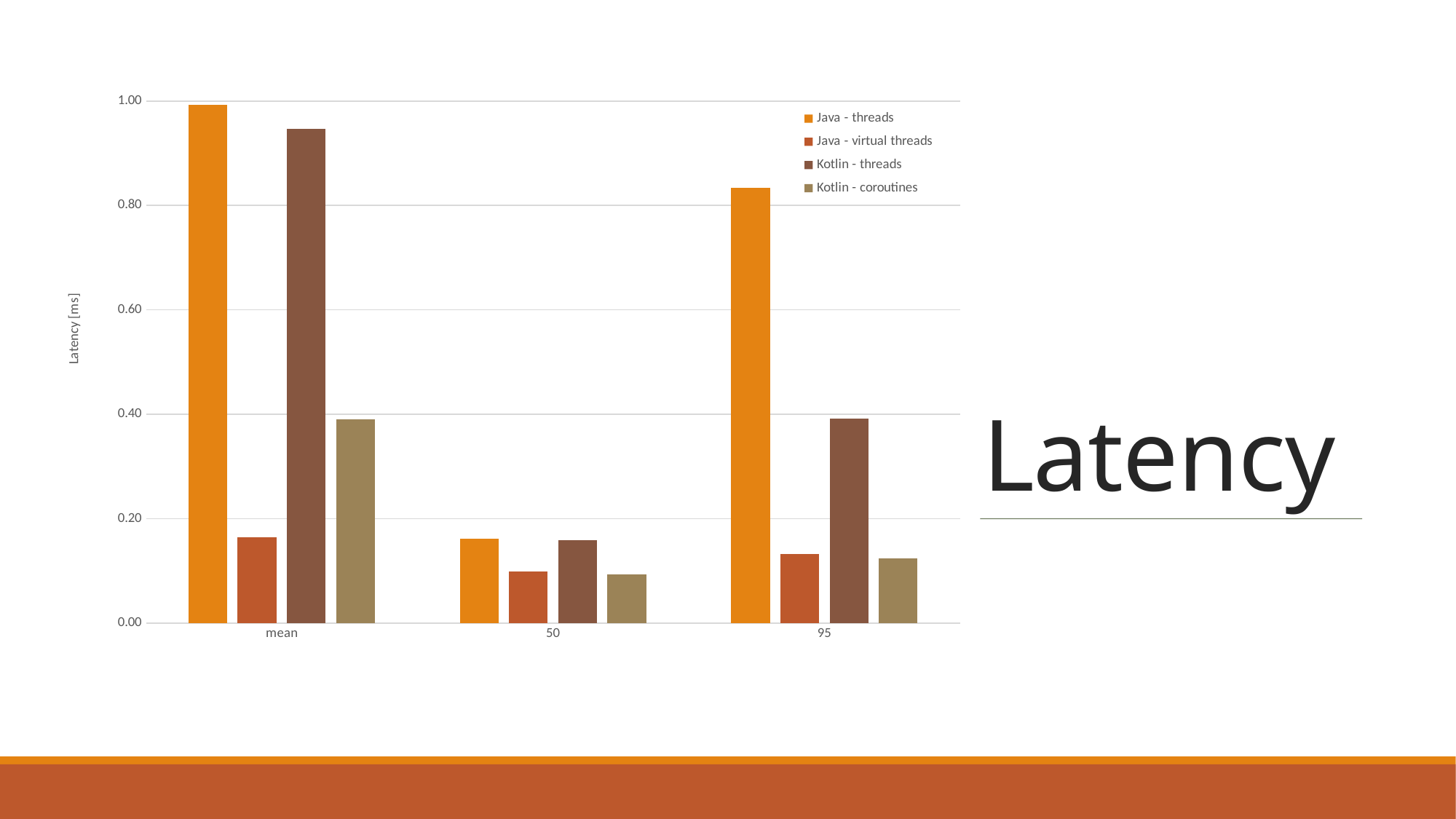
What kind of chart is shown on the slide? bar chart How many series does the chart's legend list? 4 In the '95' category, which is larger: Java - threads or Java - virtual threads? Java - threads How many categories are shown on the x axis of the chart? 3 Is the value for Java - virtual threads in the '50' category greater or less than 0.20? less Which series has the highest value in the '95' category? Java - threads Which series has the lowest value in the 'mean' category? Java - virtual threads Is the value for Kotlin - coroutines in the 'mean' category greater or less than 0.20? greater In the 'mean' category, which is larger: Kotlin - threads or Kotlin - coroutines? Kotlin - threads What is the label of the chart's vertical axis? Latency [ms] Is the value for Java - threads in the 'mean' category greater or less than 0.80? greater